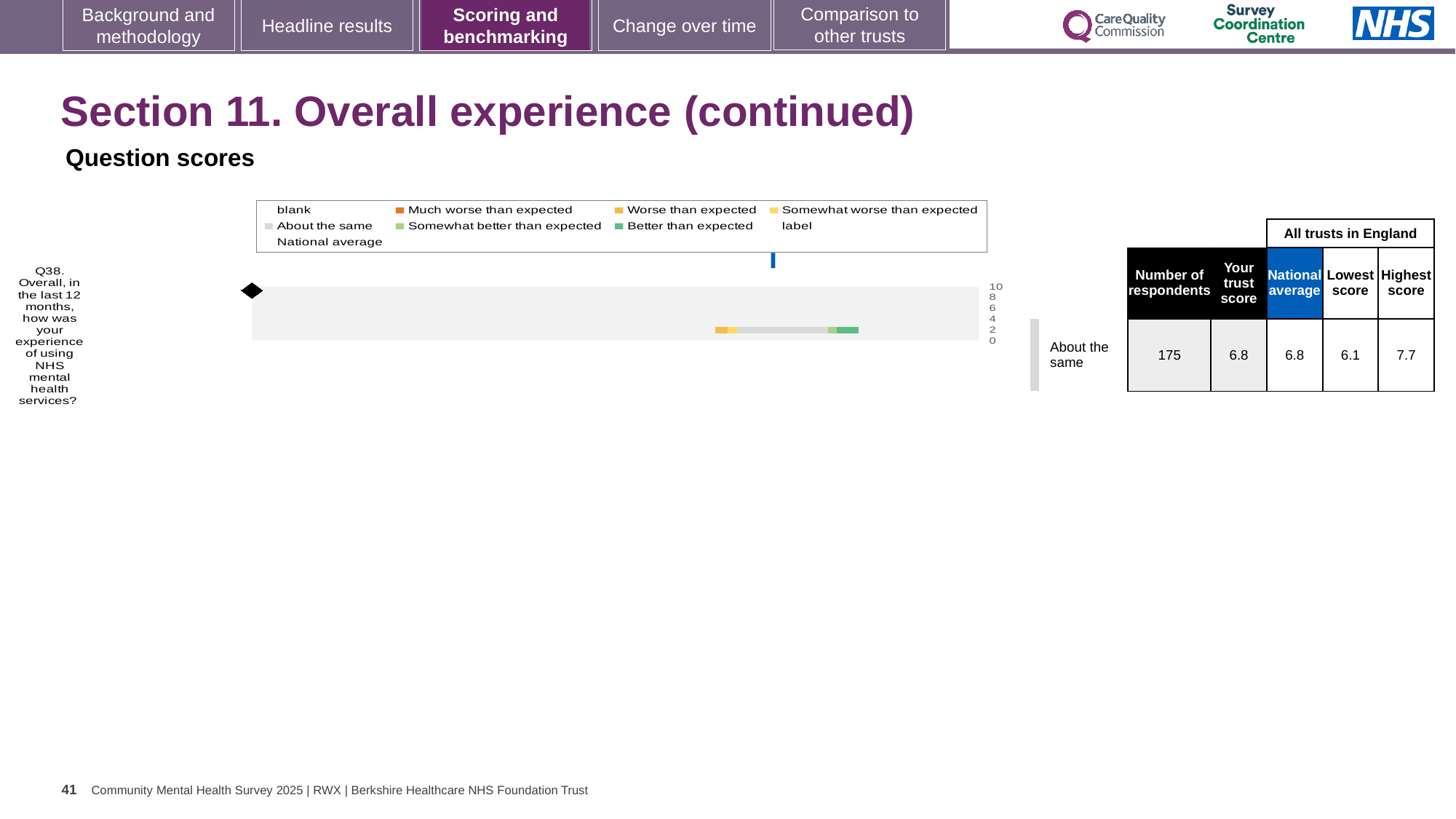
What is the highest score across all trusts in England for Q38 shown in the table? 7.7 What is the national average for Q38 shown in the table beside the chart? 6.8 What colour does the legend use for 'Better than expected'? Green How many entries does the chart legend list? 9 What is the difference between the highest score and the lowest score for Q38 in the table? 1.6 What kind of chart is shown on the slide? Bar chart What is the benchmark category shown for Q38 next to the chart? About the same Is the highest score for Q38 (7.7) larger or smaller than the trust score (6.8)? Larger What is the number of respondents for Q38 shown in the table beside the chart? 175 How many questions (categories) are plotted on the chart? 1 What is the trust score for Q38 shown in the table beside the chart? 6.8 Which question is plotted on the chart? Q38. Overall, in the last 12 months, how was your experience of using NHS mental health services?